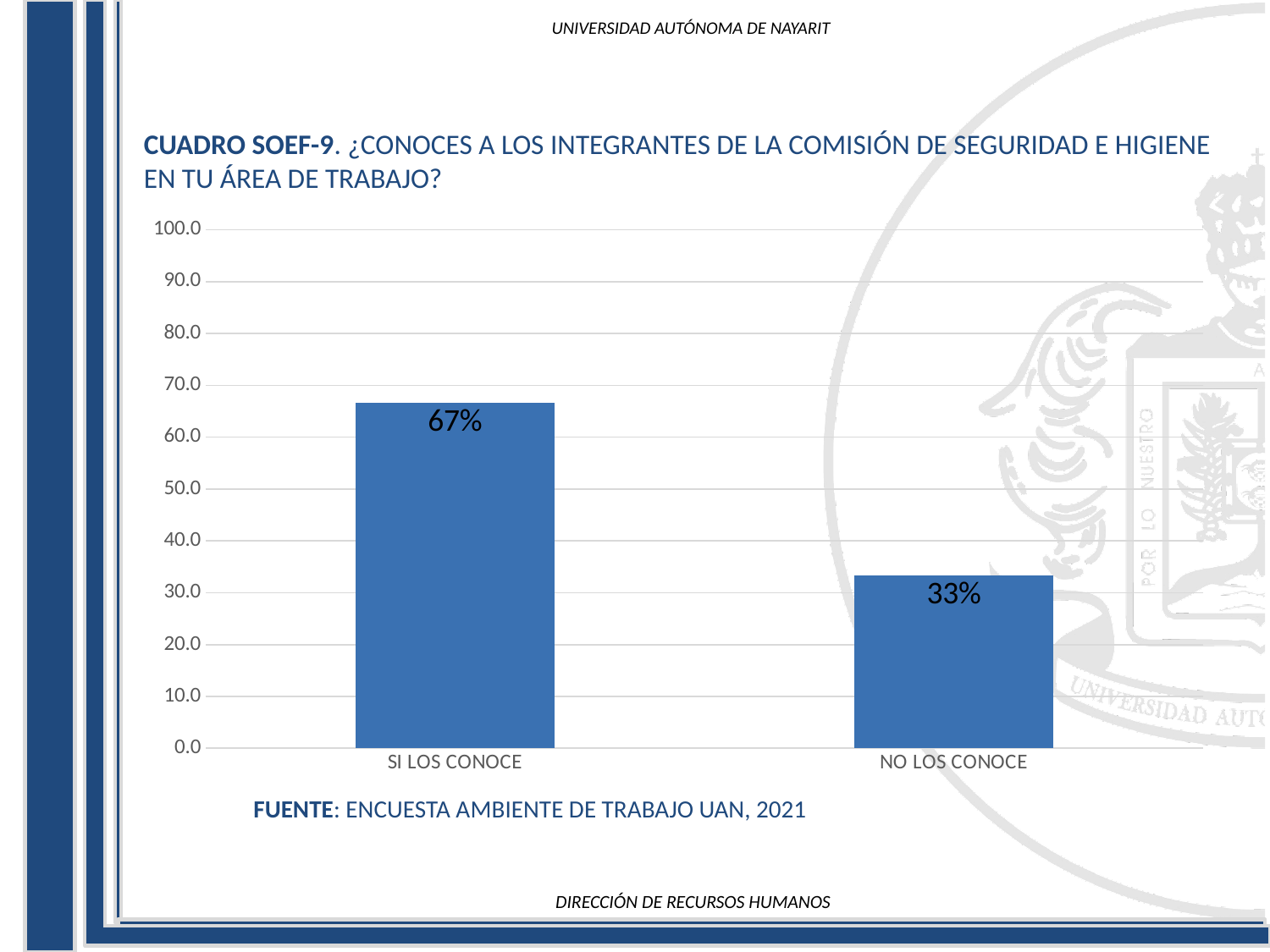
Which category has the lowest value? NO LOS CONOCE What is the source cited below the chart? ENCUESTA AMBIENTE DE TRABAJO UAN, 2021 What is the value for SI LOS CONOCE? 67% What is the difference between the values for SI LOS CONOCE and NO LOS CONOCE? 34% Which category has the highest value? SI LOS CONOCE Which is larger, the value for SI LOS CONOCE or the value for NO LOS CONOCE? SI LOS CONOCE What is the value for NO LOS CONOCE? 33% Is the value for SI LOS CONOCE greater or less than 60.0? greater What is the maximum value shown on the vertical axis? 100.0 Is the value for NO LOS CONOCE greater or less than 40.0? less What kind of chart is shown on the slide? bar chart How many categories are shown on the chart? 2